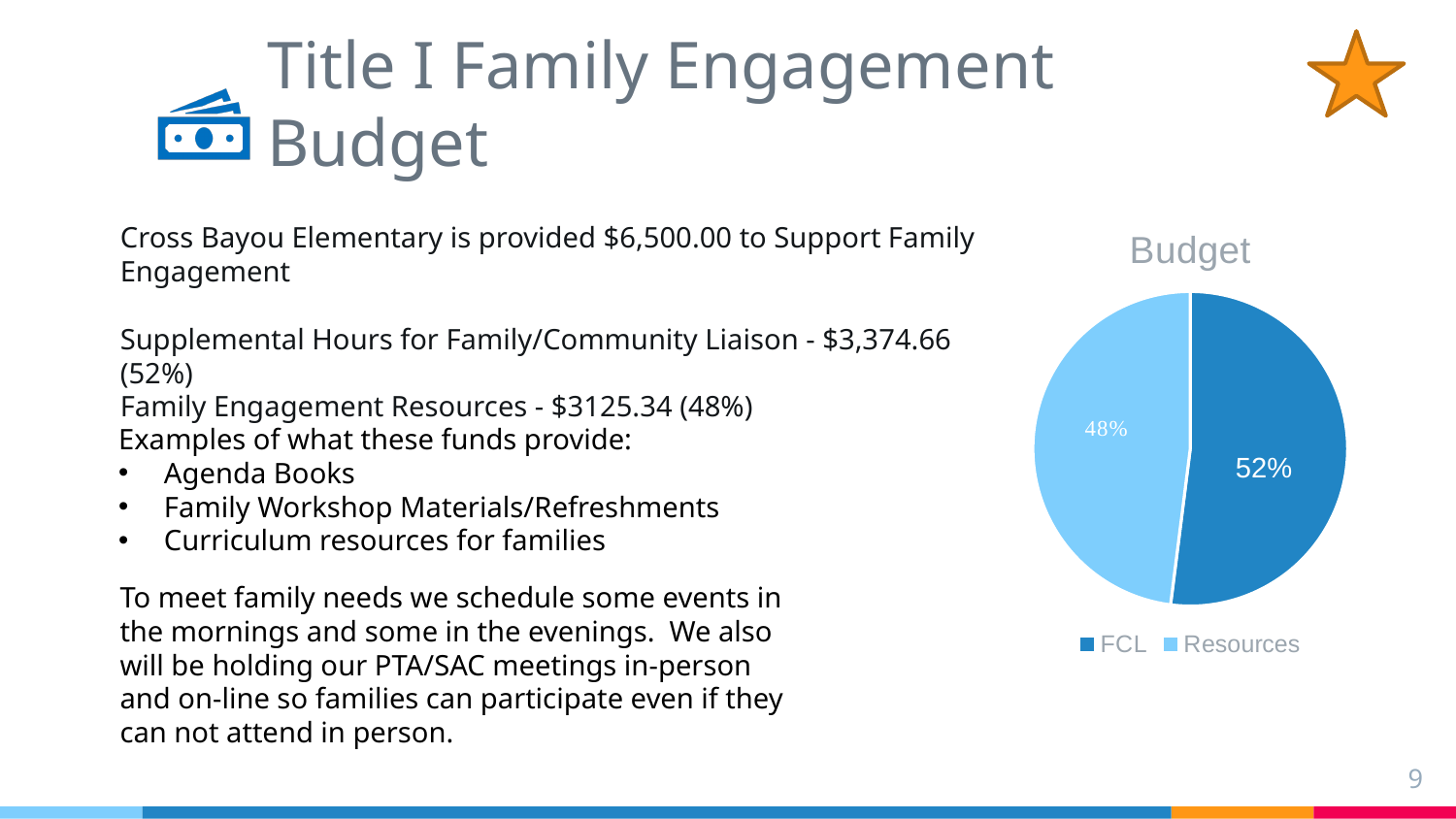
Which slice of the pie is the smallest? Resources What share of the pie does FCL represent? 52% Which legend entry is shown in the lighter blue colour? Resources How many entries does the chart legend list? 2 Which is larger, the FCL slice or the Resources slice? FCL What is the difference in percentage points between the FCL slice and the Resources slice? 4 Which slice of the pie is the largest? FCL How many slices does the pie chart have? 2 What kind of chart is shown on the slide? pie chart What is the title of the chart? Budget What share of the pie does Resources represent? 48%